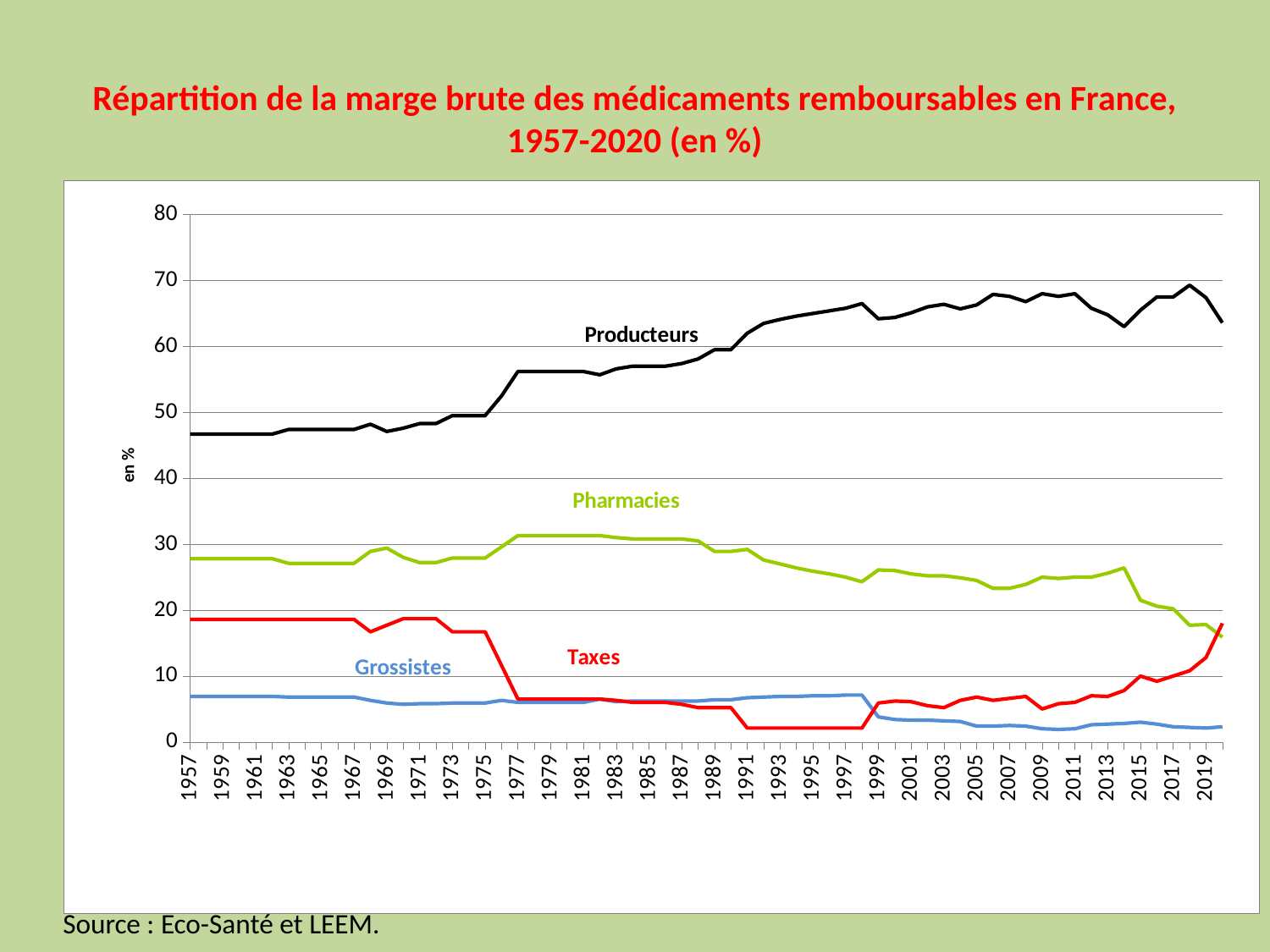
Which series has the lowest value in 2020? Grossistes Is the value for Producteurs in 1957 greater or less than 50? less Is the value for Pharmacies in 2020 greater or less than 20? less Is the value for Taxes in 1995 greater or less than 10? less How many series are plotted on the chart? 4 Does the Pharmacies series generally rise or fall from 1977 to 2020? Fall Which series has the highest values across the whole period? Producteurs Does the Producteurs series generally rise or fall from 1957 to 2020? Rise What kind of chart is shown on the slide? Line chart What is the label on the vertical axis? en % In 2020, which is larger, Taxes or Grossistes? Taxes